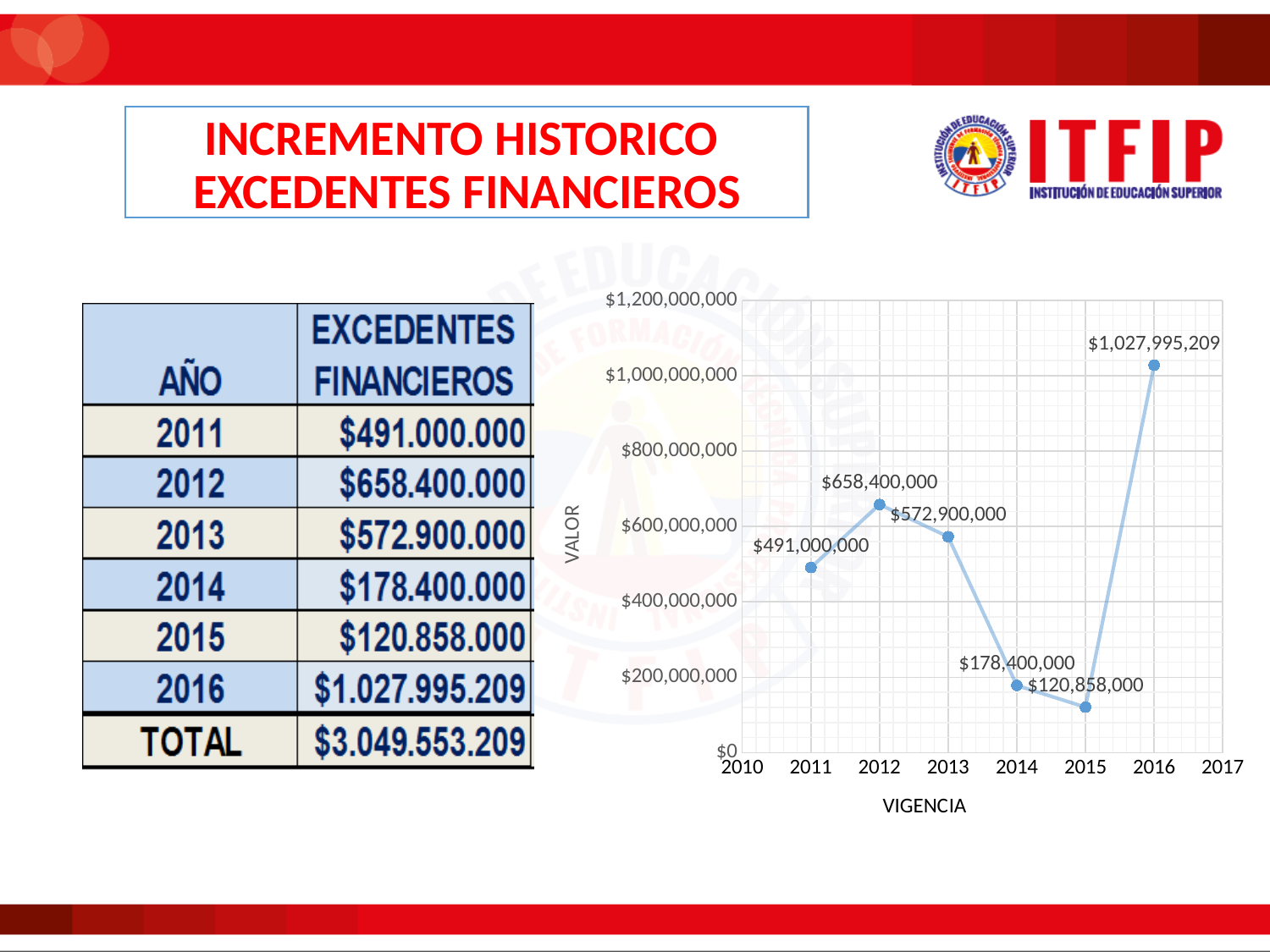
How many data points are plotted in the chart? 6 What is the label of the horizontal axis of the chart? VIGENCIA Is the value for 2015 greater or less than $200,000,000? less What is the difference between the values for 2012 and 2013? $85,500,000 Which year has the highest value in the chart? 2016 What is the value plotted for 2016? $1,027,995,209 What is the value plotted for 2011? $491,000,000 Which year has the lowest value in the chart? 2015 What is the value plotted for 2014? $178,400,000 Do the values rise or fall from 2013 to 2015? fall What type of chart is shown on the slide? line chart Which is larger, the value for 2011 or the value for 2013? 2013